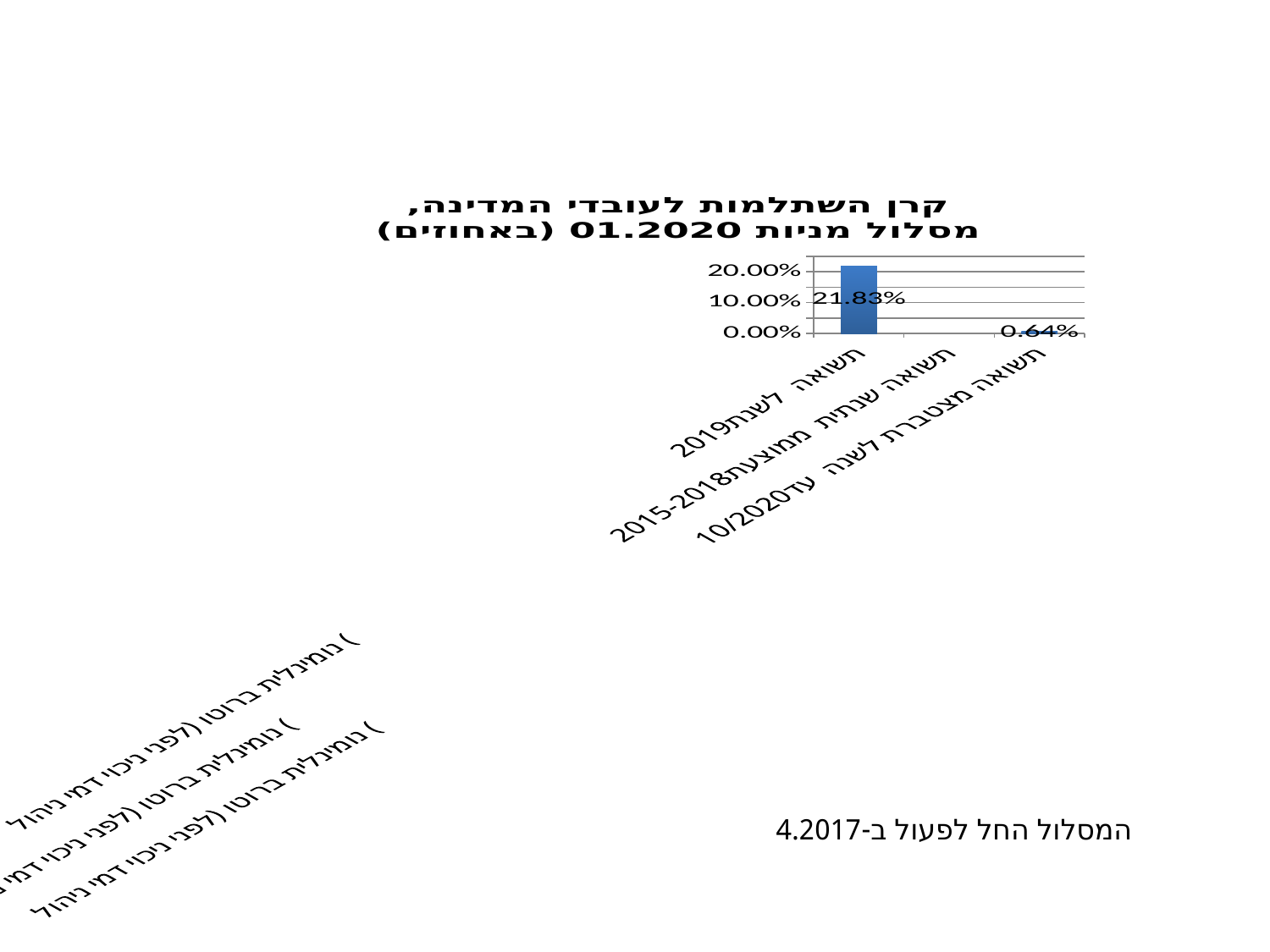
What is the highest tick value shown on the y axis of the chart? 20.00% What is the value for "תשואה לשנת 2019"? 21.83% How many categories are shown on the x axis of the chart? 3 What is the difference between the value for "תשואה לשנת 2019" and the value for "תשואה מצטברת לשנה עד 10/2020"? 21.19% Is the value for "תשואה לשנת 2019" greater or less than 20.00%? greater Which is larger: the value for "תשואה לשנת 2019" or the value for "תשואה מצטברת לשנה עד 10/2020"? תשואה לשנת 2019 What kind of chart is shown on the slide? bar chart What is the value for "תשואה מצטברת לשנה עד 10/2020"? 0.64% What is the title of the chart? קרן השתלמות לעובדי המדינה, מסלול מניות 01.2020 (באחוזים) Which category has the highest value? תשואה לשנת 2019 Is the value for "תשואה מצטברת לשנה עד 10/2020" greater or less than 10.00%? less